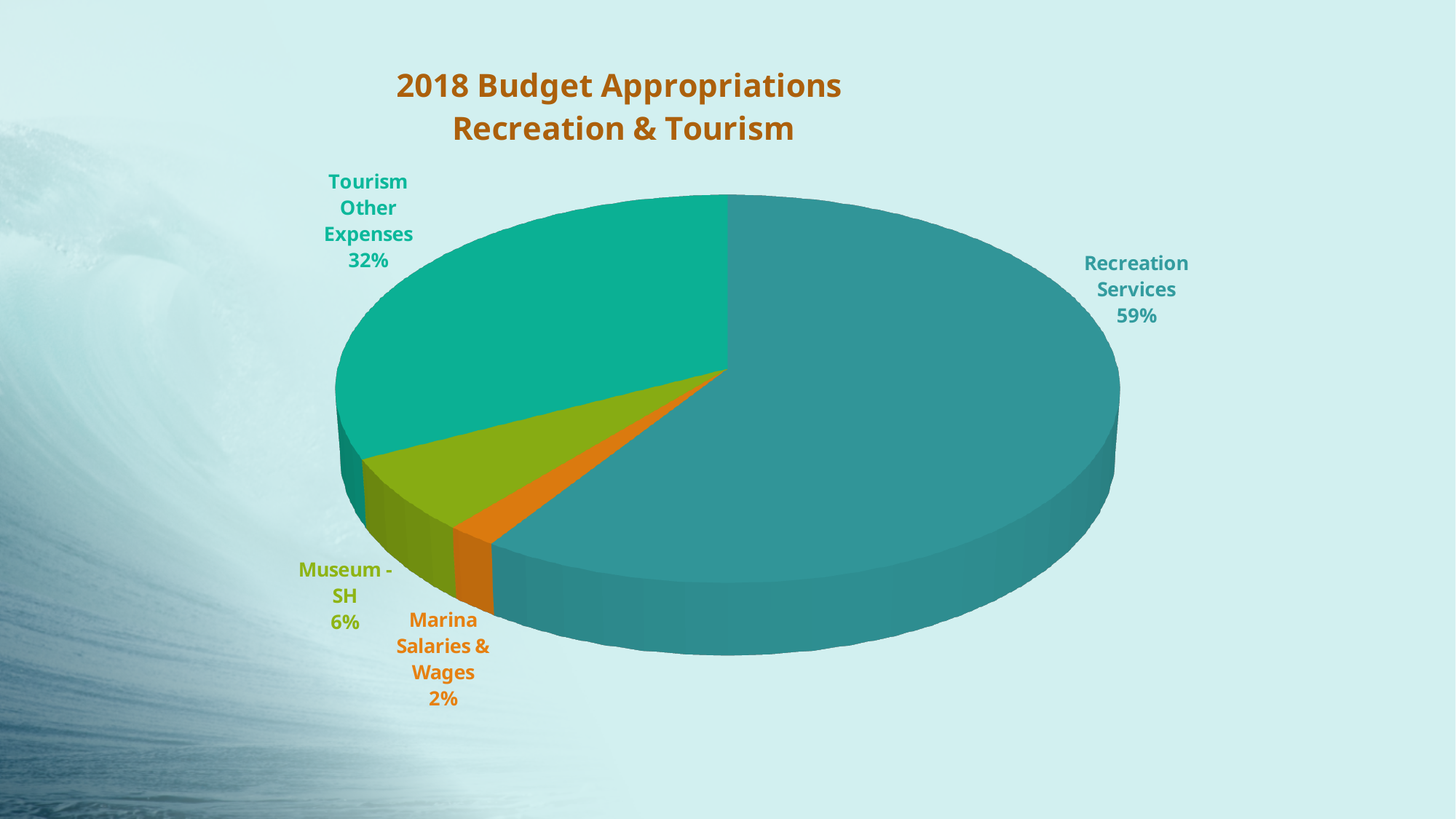
Which is larger, Museum - SH or Marina Salaries & Wages? Museum - SH What is the difference in percentage points between Recreation Services and Tourism Other Expenses? 27 Which category has the largest slice of the pie? Recreation Services What share of the pie is Marina Salaries & Wages? 2% What is the difference in percentage points between Museum - SH and Marina Salaries & Wages? 4 What kind of chart is shown on the slide? Pie chart Which category has the smallest slice of the pie? Marina Salaries & Wages What share of the pie is Museum - SH? 6% What is the title of the chart? 2018 Budget Appropriations Recreation & Tourism What share of the pie is Tourism Other Expenses? 32% How many slices does the pie chart have? 4